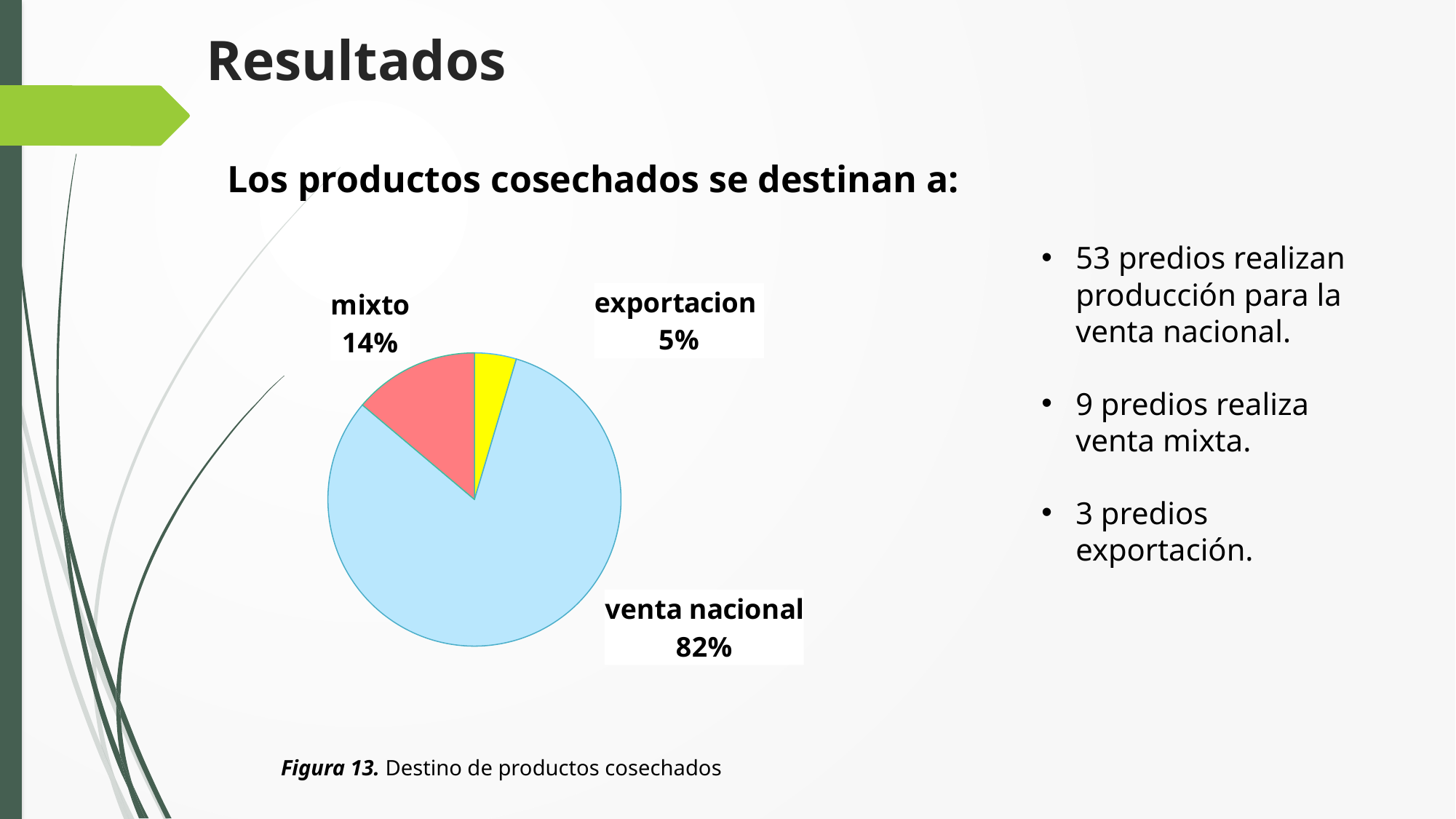
What share of the pie does exportacion represent? 5% Which category has the largest slice of the pie? venta nacional What type of chart is shown on the slide? pie chart What colour is the venta nacional slice? light blue How many categories are shown in the pie chart? 3 What is the figure caption of the chart? Figura 13. Destino de productos cosechados Which is larger, the mixto slice or the exportacion slice? mixto What share of the pie does mixto represent? 14% Which category has the smallest slice of the pie? exportacion What is the difference in percentage points between mixto and exportacion? 9 What share of the pie does venta nacional represent? 82% What is the difference in percentage points between venta nacional and mixto? 68